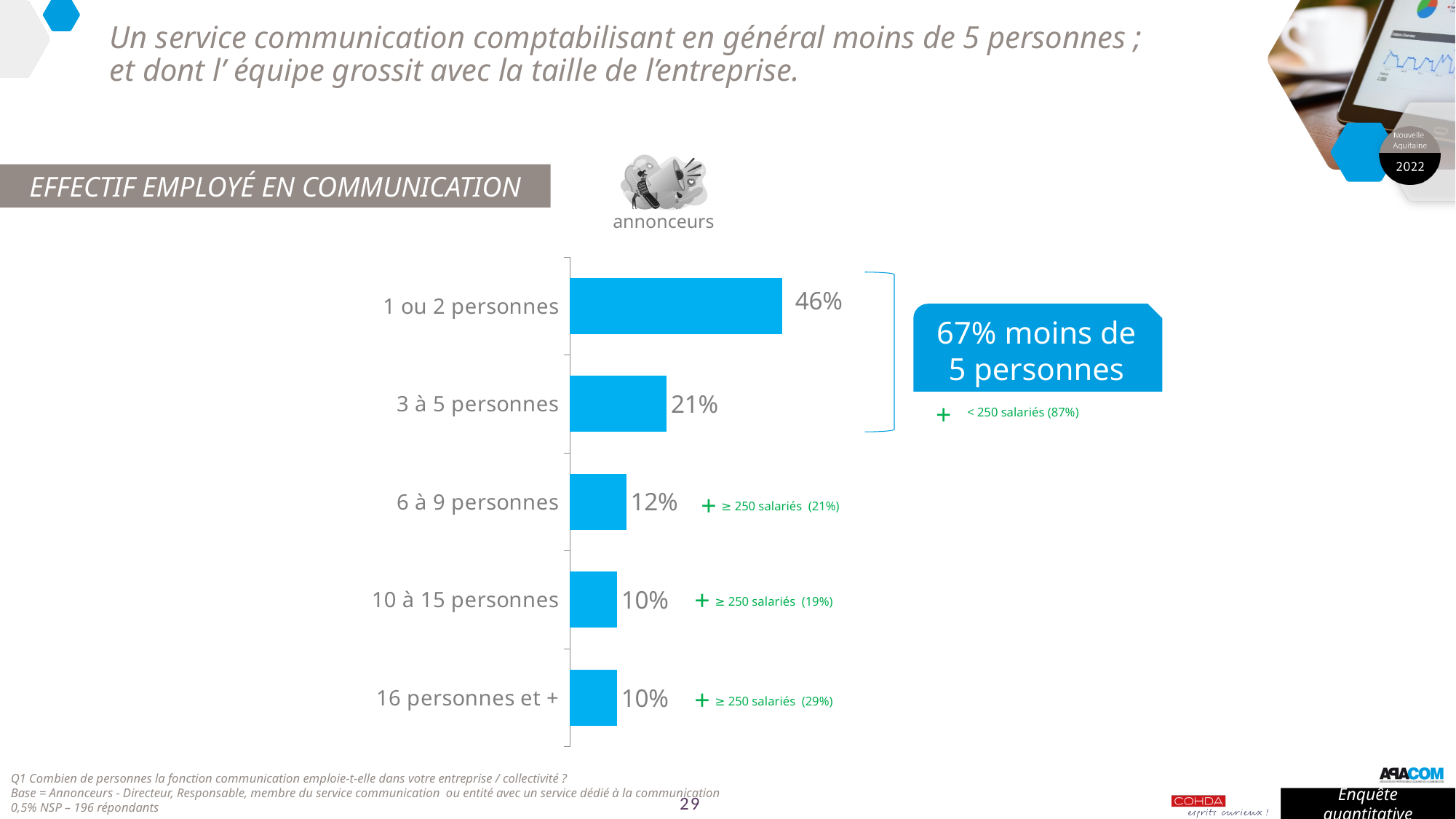
What is the value shown for 3 à 5 personnes? 21% Which category has the highest value? 1 ou 2 personnes What is the title of the chart section on the slide? EFFECTIF EMPLOYÉ EN COMMUNICATION How many categories are shown in the bar chart? 5 Which is larger, the value for 3 à 5 personnes or the value for 6 à 9 personnes? 3 à 5 personnes What percentage is shown in the blue callout box next to the chart? 67% What is the difference between the values for 1 ou 2 personnes and 3 à 5 personnes? 25 percentage points What is the value shown for 6 à 9 personnes? 12% What is the combined total of the 1 ou 2 personnes and 3 à 5 personnes categories? 67% What is the value shown for 16 personnes et +? 10% What kind of chart is shown on the slide? Bar chart What percentage of annonceurs have a communication team of 1 ou 2 personnes? 46%